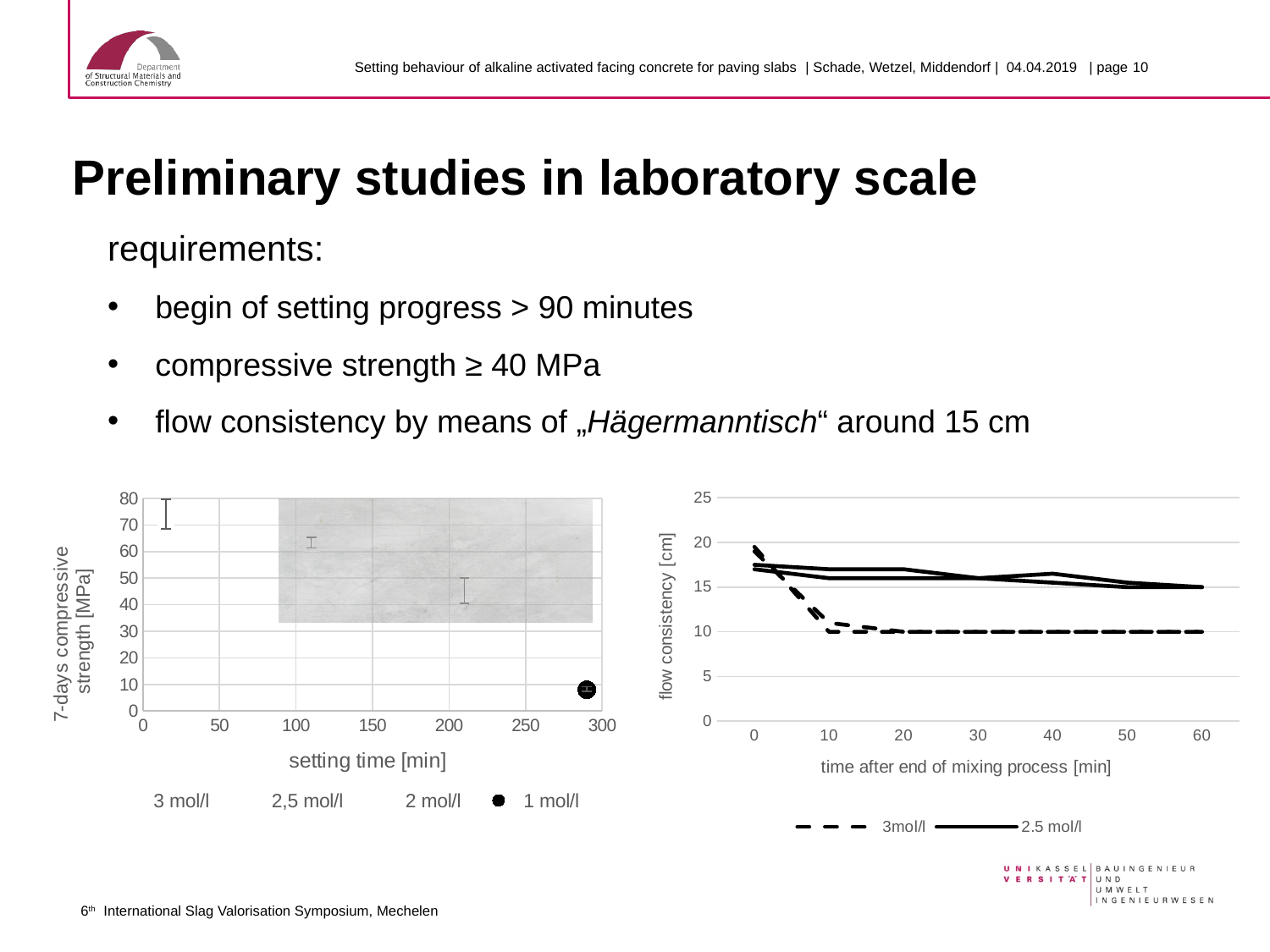
In the right chart, does the flow consistency of 3mol/l rise or fall as time after end of mixing increases? fall In the left chart, is the setting time for 1 mol/l greater or less than 250 min? greater How many series does the legend of the right chart list? 2 What kind of chart is the right chart (flow consistency vs time after end of mixing process)? line chart In the left chart, which series has the lowest 7-days compressive strength? 1 mol/l What is the y-axis label of the right chart? flow consistency [cm] In the right chart, is the flow consistency of 3mol/l at 60 min greater or less than 15 cm? less What kind of chart is the left chart (7-days compressive strength vs setting time)? scatter chart In the left chart, is the 7-days compressive strength for 1 mol/l greater or less than 20 MPa? less What is the x-axis label of the left chart? setting time [min] How many series does the legend of the left chart list? 4 In the right chart, at 60 min, which series has the higher flow consistency, 3mol/l or 2.5 mol/l? 2.5 mol/l